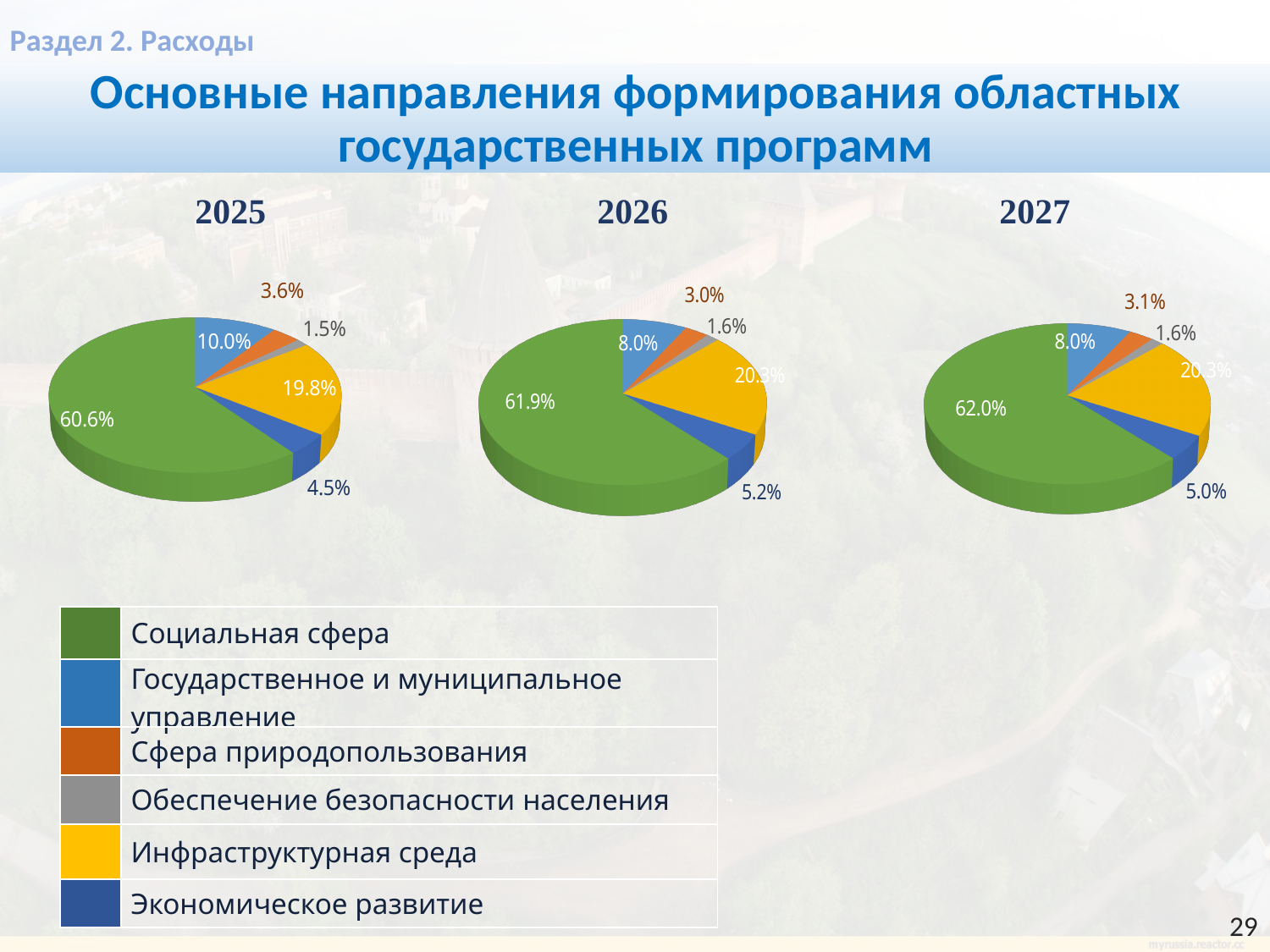
What is the difference between the share of Социальная сфера in 2027 and in 2025? 1.4% What kind of charts are shown on the slide? Pie charts Which colour represents Инфраструктурная среда in the legend? Yellow In the 2025 pie chart, what is the share of Инфраструктурная среда? 19.8% In the 2026 pie chart, which category has the largest share? Социальная сфера How many pie charts are on the slide? 3 In the 2026 pie chart, what is the share of Экономическое развитие? 5.2% In the 2025 pie chart, what is the share of Социальная сфера? 60.6% In the 2027 pie chart, what is the share of Государственное и муниципальное управление? 8.0% In the 2027 pie chart, which category has the smallest share? Обеспечение безопасности населения In the 2025 pie chart, which is larger: the share of Государственное и муниципальное управление or the share of Экономическое развитие? Государственное и муниципальное управление How many categories does the legend list? 6